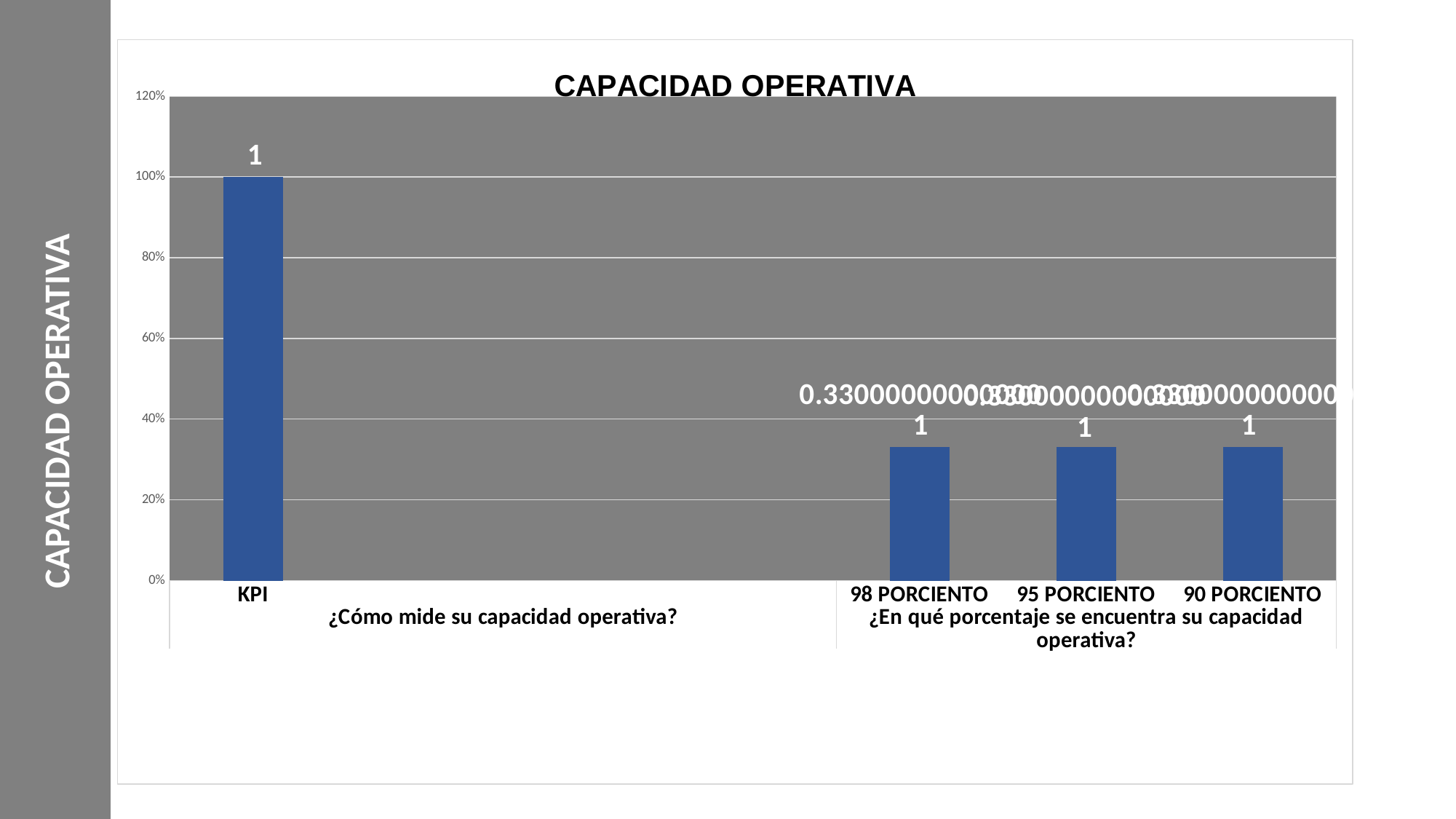
What is the title of the chart? CAPACIDAD OPERATIVA Is the value for 98 PORCIENTO greater or less than 40%? less How many categories are grouped under the question '¿En qué porcentaje se encuentra su capacidad operativa?'? 3 What question label appears beneath the KPI bar on the x axis? ¿Cómo mide su capacidad operativa? Is the value for 95 PORCIENTO greater or less than 20%? greater Is the value for KPI greater or less than 80%? greater What kind of chart is shown on the slide? bar chart Which category has the highest bar? KPI What is the data label shown on the KPI bar? 1 How many bars are plotted in the chart? 4 Which bar is taller, KPI or 90 PORCIENTO? KPI